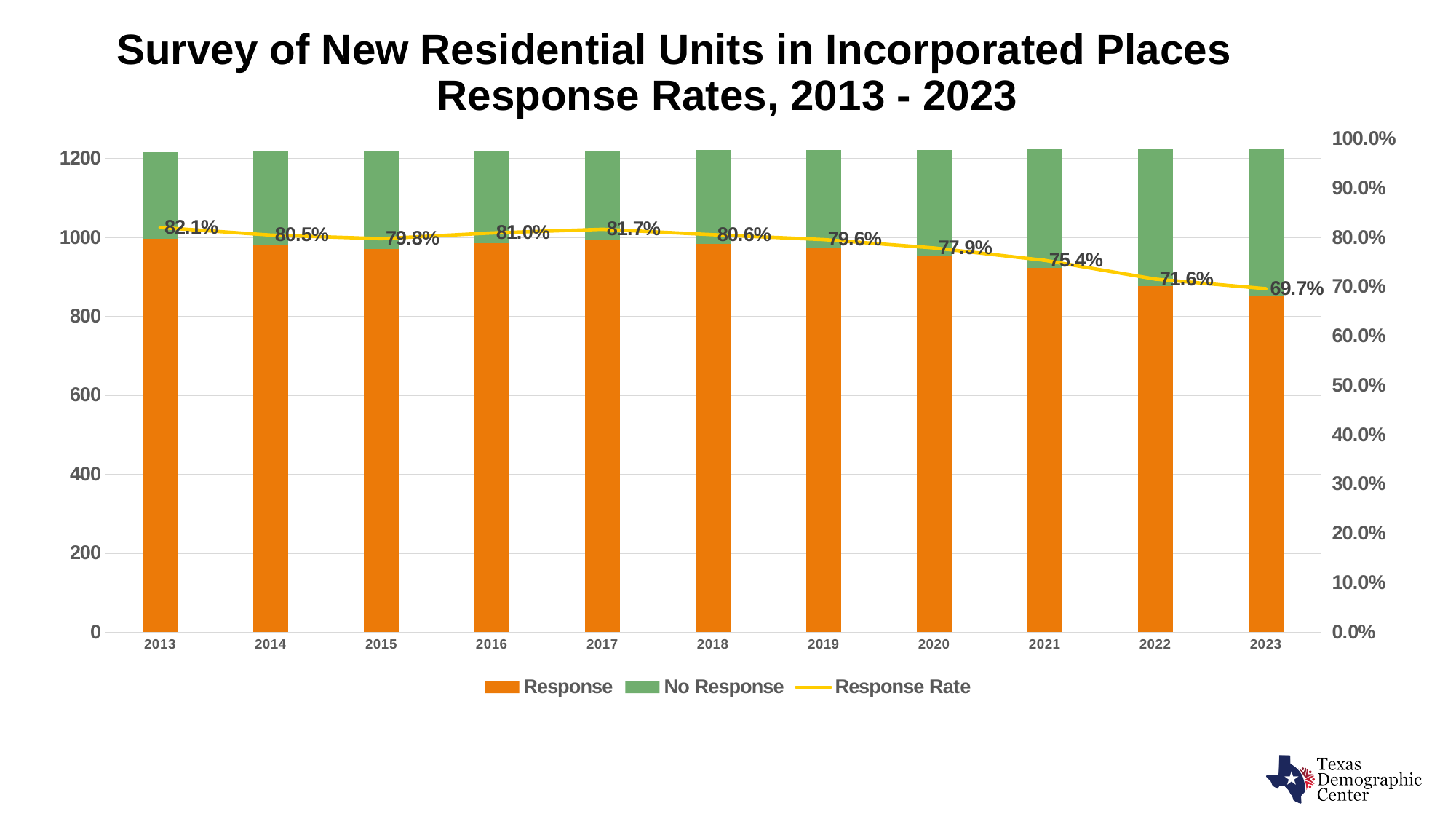
What is the Response Rate for 2023? 69.7% What kind of chart is this? A stacked bar chart with a line Which year has the highest Response Rate? 2013 Is the Response value for 2023 greater or less than 1000? less How many series does the legend list? 3 Which year has the higher Response Rate, 2016 or 2019? 2016 Does the Response Rate rise or fall from 2017 to 2023? fall What is the Response Rate for 2020? 77.9% By how many percentage points did the Response Rate fall from 2013 to 2023? 12.4 percentage points Which year has the lowest Response Rate? 2023 What is the Response Rate for 2013? 82.1% How many years are shown on the x axis? 11